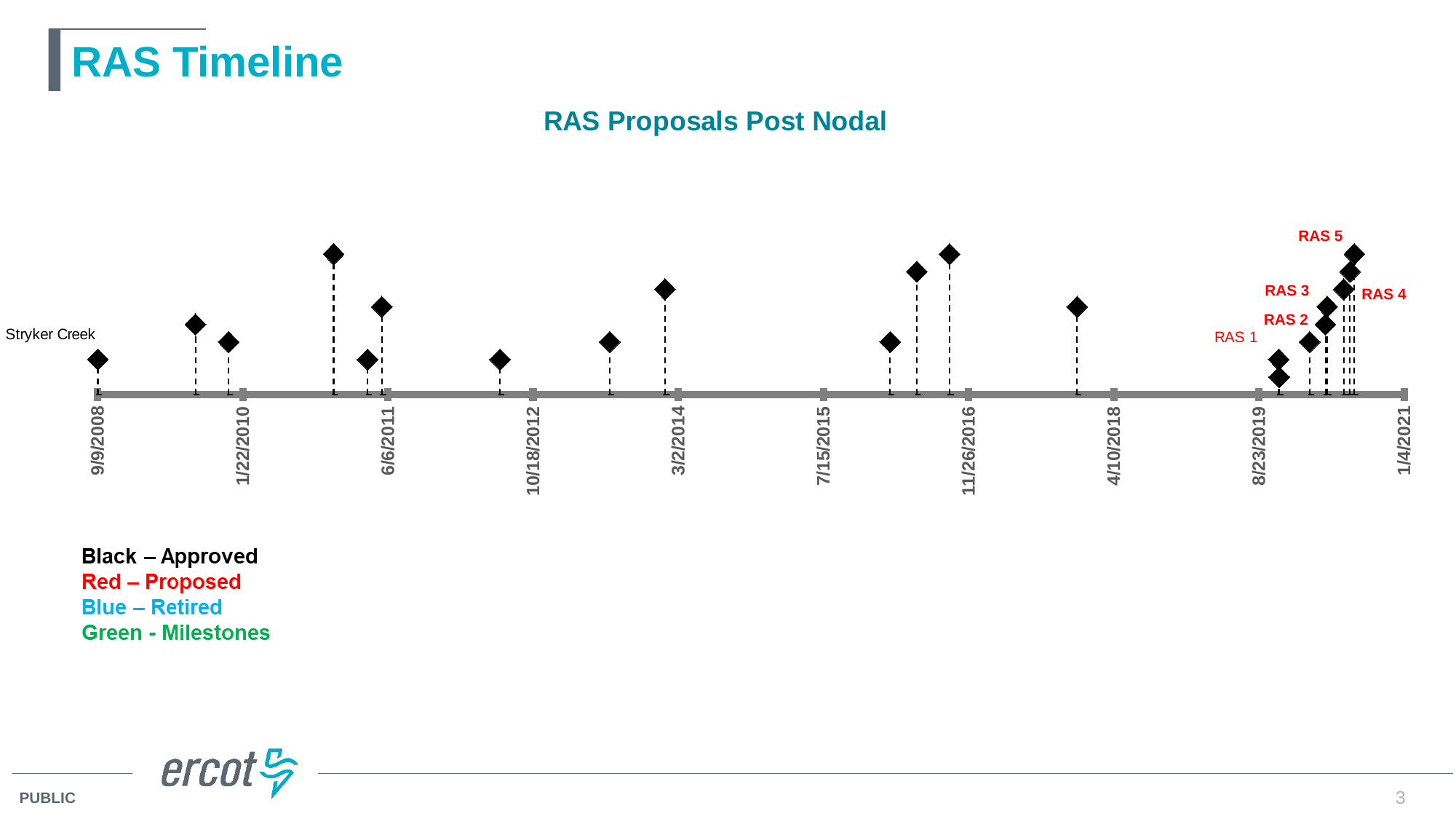
Which of the labelled RAS proposals (RAS 1 to RAS 5) is the earliest on the timeline? RAS 1 What is the latest date labelled on the timeline axis? 1/4/2021 Which of the labelled RAS proposals (RAS 1 to RAS 5) is the latest on the timeline? RAS 5 Is the RAS 5 marker placed before or after the 1/4/2021 tick? before What is the earliest date labelled on the timeline axis? 9/9/2008 What is the title of the chart? RAS Proposals Post Nodal Which is earlier on the timeline, Stryker Creek or RAS 1? Stryker Creek What kind of chart is shown on the slide? timeline chart How many date labels are shown along the timeline axis? 10 How many colour categories does the legend below the chart list? 4 Is the RAS 1 marker placed before or after the 8/23/2019 tick? after